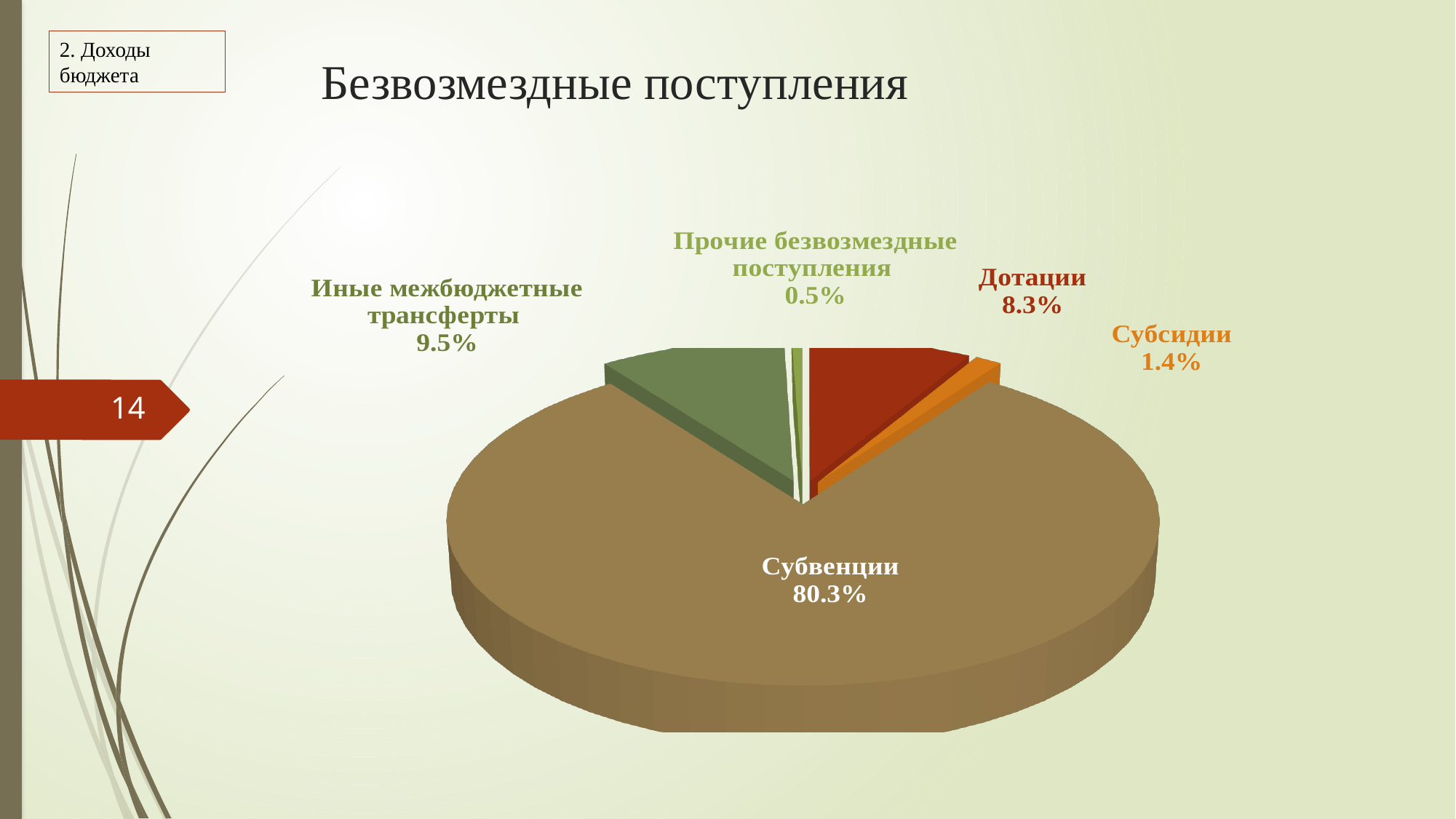
What is the value shown for Прочие безвозмездные поступления? 0.5% Which category has the largest slice of the pie? Субвенции What is the value shown for Иные межбюджетные трансферты? 9.5% Which category has the smallest slice of the pie? Прочие безвозмездные поступления How many categories are shown in the pie chart? 5 What is the title of the chart? Безвозмездные поступления Which is larger, Дотации or Субсидии? Дотации What is the value shown for Субсидии? 1.4% What kind of chart is shown on the slide? Pie chart What is the value shown for Дотации? 8.3% What is the difference in percentage points between Иные межбюджетные трансферты and Дотации? 1.2 What share of the pie does Субвенции have? 80.3%